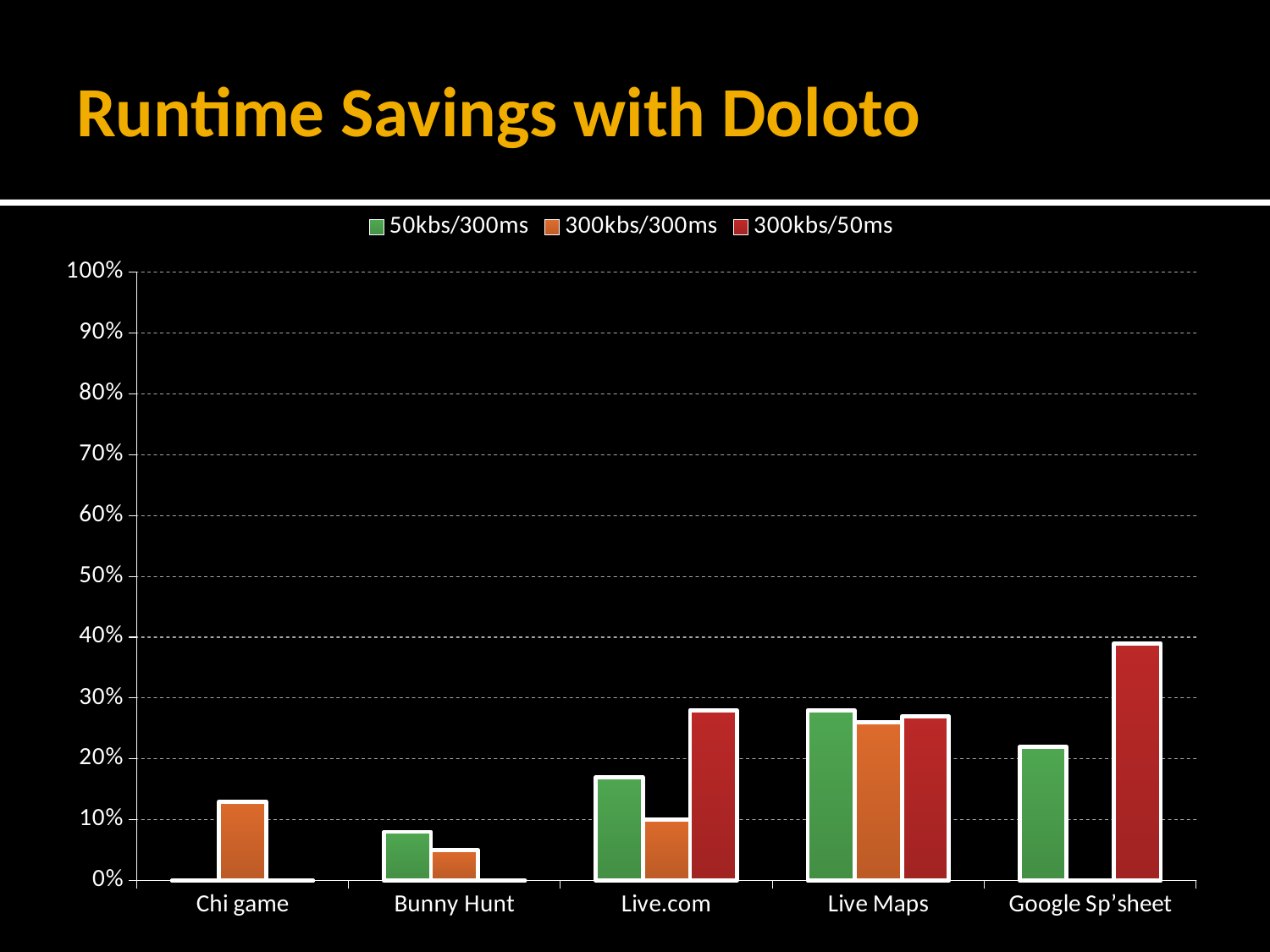
For Live.com, which is larger: the 300kbs/50ms value or the 50kbs/300ms value? 300kbs/50ms How many categories are shown on the x axis? 5 How many series does the legend list? 3 For Bunny Hunt, which is larger: the 50kbs/300ms value or the 300kbs/300ms value? 50kbs/300ms Which category has the highest 300kbs/50ms bar? Google Sp'sheet Which category has the highest 300kbs/300ms bar? Live Maps Is the 300kbs/300ms value for Live.com greater or less than 20%? less What kind of chart is shown on the slide? bar chart Is the 300kbs/50ms value for Google Sp'sheet greater or less than 30%? greater What is the title of the slide? Runtime Savings with Doloto Is the 300kbs/300ms value for Chi game greater or less than 20%? less Which category has the highest 50kbs/300ms bar? Live Maps